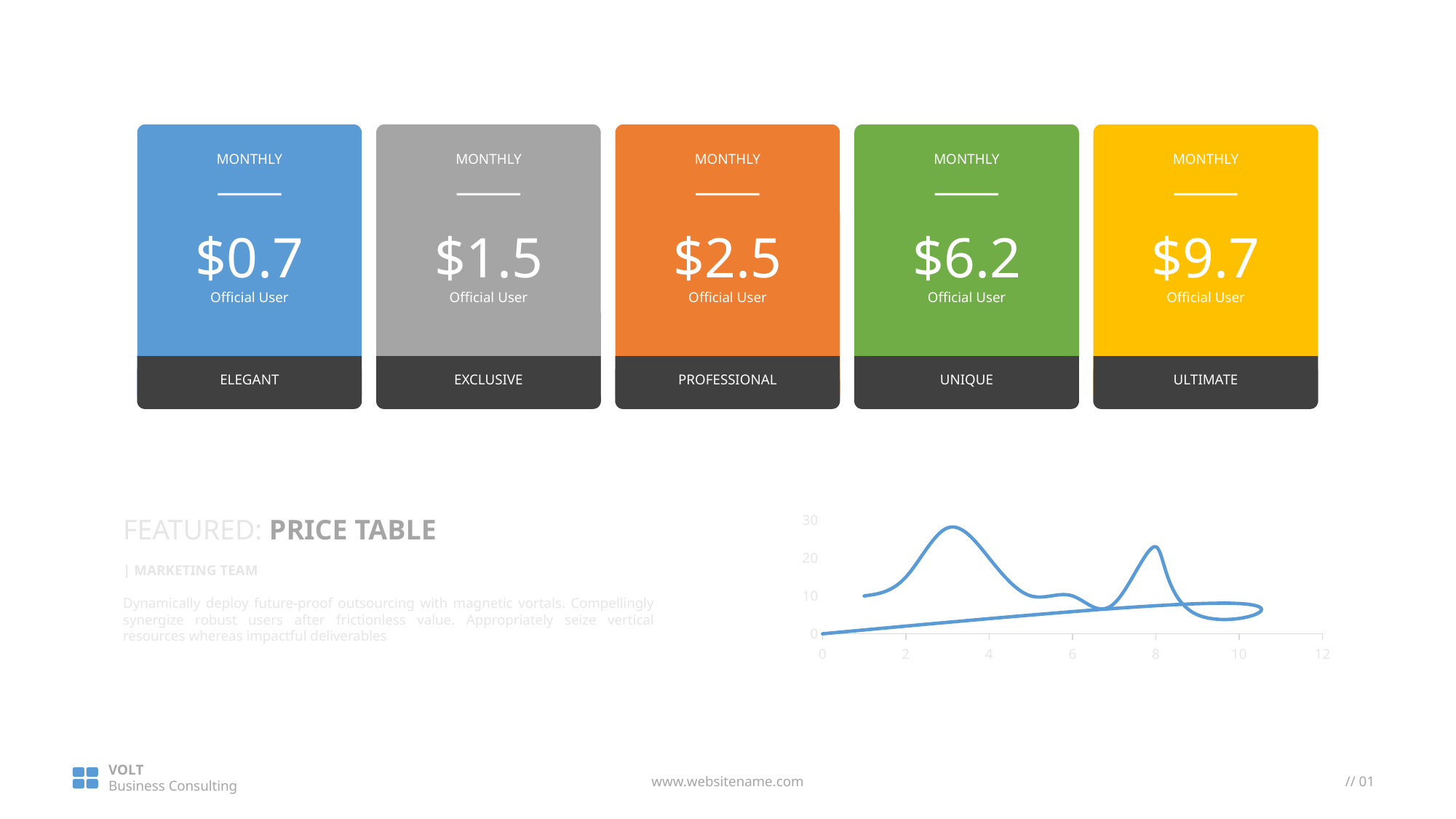
In the line chart at the bottom right, is the value at the peak near x = 3 greater or less than 30? less In the line chart at the bottom right, is the value of the curve near x = 10 greater or less than 10? less What colour is the line in the chart at the bottom right of the slide? blue What is the highest tick value shown on the y axis of the line chart at the bottom right? 30 What kind of chart is shown at the bottom right of the slide? line chart In the line chart at the bottom right, is the value at the peak near x = 8 greater or less than 20? greater In the line chart at the bottom right, which peak is higher: the one near x = 3 or the one near x = 8? the one near x = 3